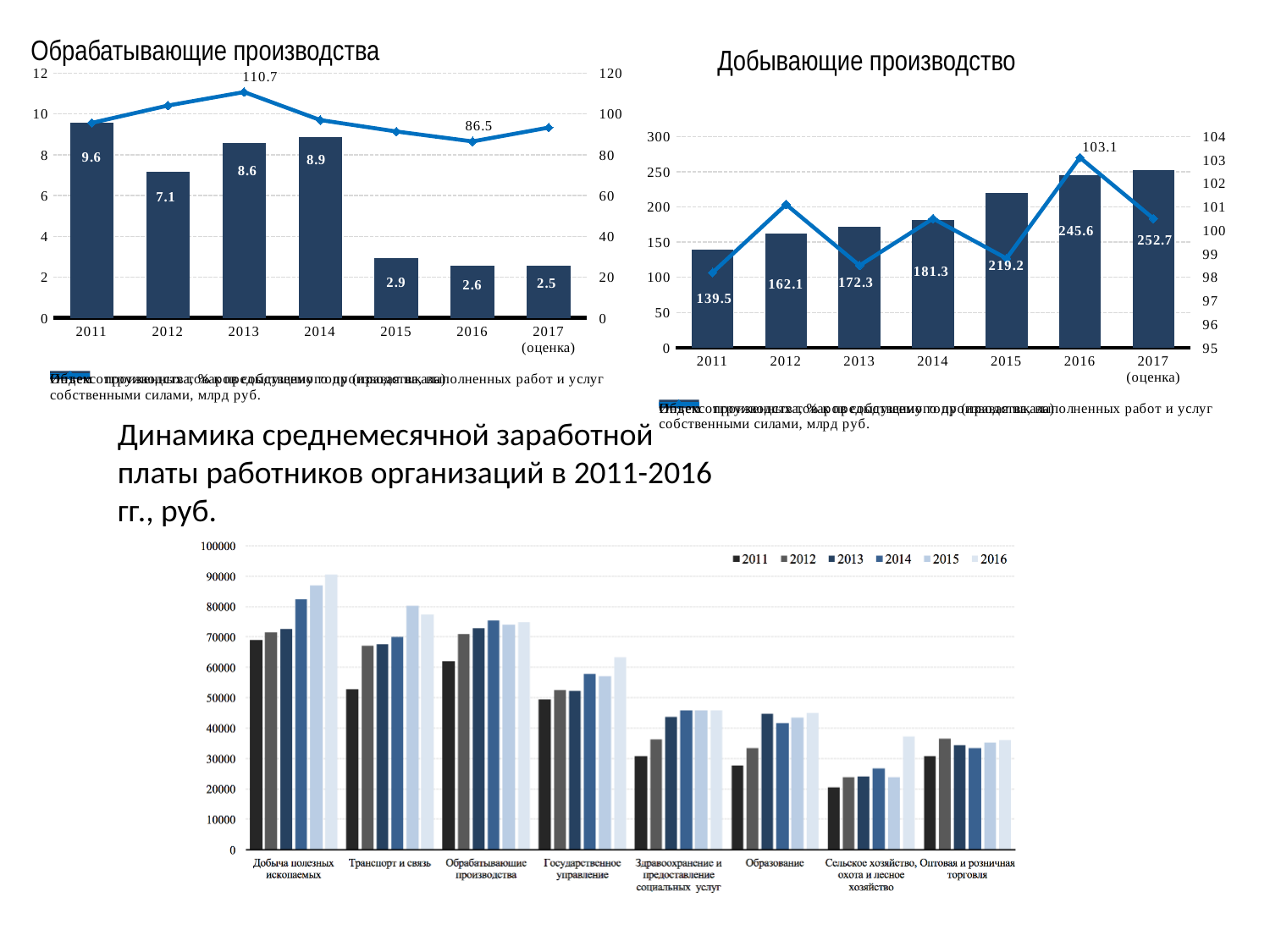
In the 'Обрабатывающие производства' chart, which year has the highest bar value? 2011 In the 'Добывающие производство' chart, what is the line value labelled for 2016? 103.1 In the 'Обрабатывающие производства' chart, what is the bar value for 2017 (оценка)? 2.5 In the 'Динамика среднемесячной заработной платы' chart, is the 2011 value for 'Сельское хозяйство, охота и лесное хозяйство' greater or less than 30000? less How many series does the legend list in the 'Динамика среднемесячной заработной платы' chart? 6 In the 'Добывающие производство' chart, what is the difference between the bar values for 2017 (оценка) and 2016? 7.1 In the 'Обрабатывающие производства' chart, what is the bar value for 2011? 9.6 In the 'Добывающие производство' chart, do the bar values rise or fall from 2011 to 2017? rise In the 'Обрабатывающие производства' chart, what is the line value labelled for 2013? 110.7 In the 'Обрабатывающие производства' chart, what is the difference between the bar values for 2014 and 2015? 6.0 In the 'Добывающие производство' chart, what is the bar value for 2015? 219.2 In the 'Добывающие производство' chart, which year has the lowest bar value? 2011